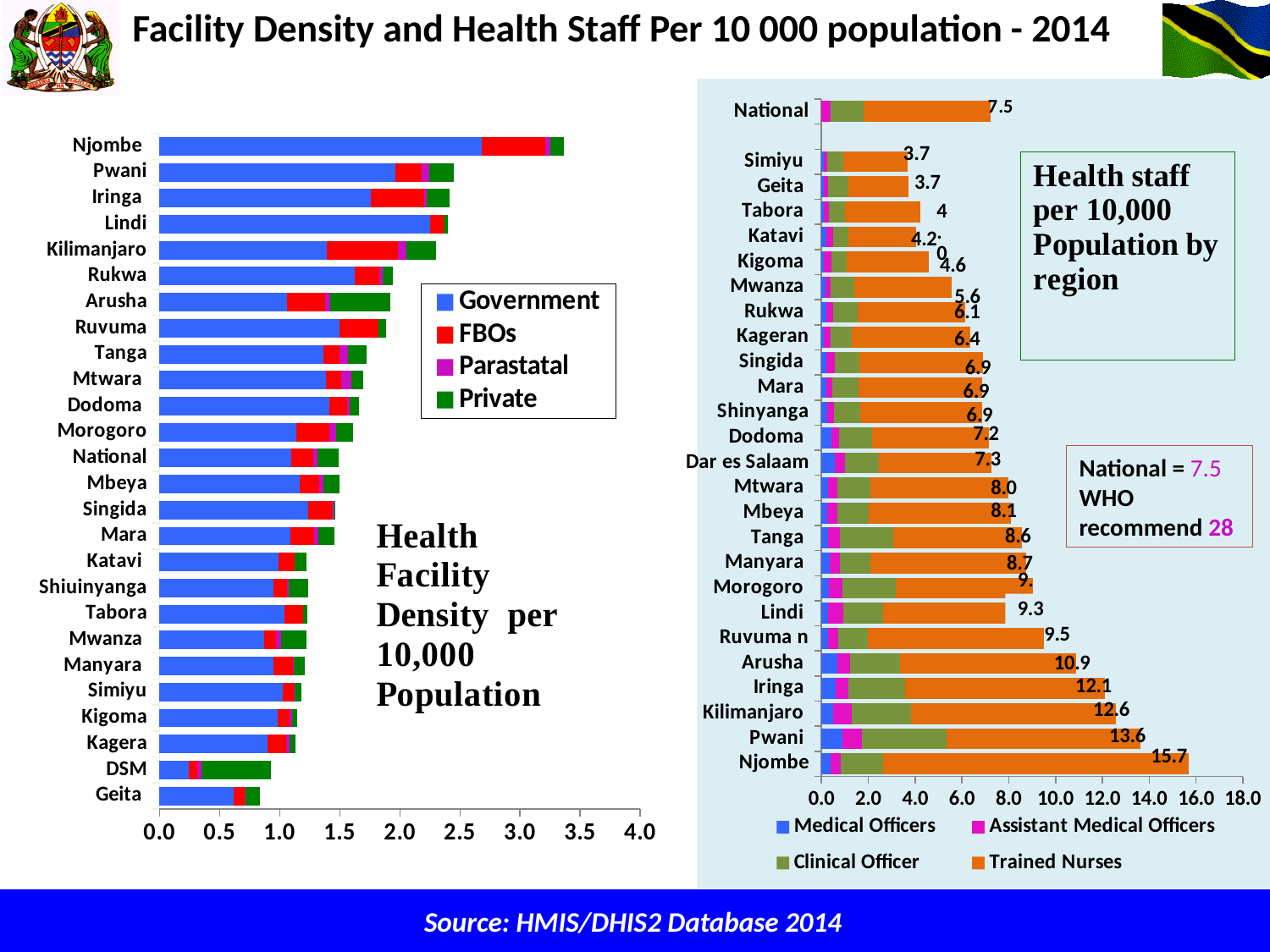
What kind of chart is the Health Facility Density per 10,000 Population chart on the left? Bar chart What are the four legend entries of the Health Facility Density per 10,000 Population chart? Government, FBOs, Parastatal, Private In the Health Facility Density per 10,000 Population chart, is the total value for Njombe greater or less than 3.0? greater In the Health staff per 10,000 Population by region chart, what is the value for Njombe? 15.7 In the Health staff per 10,000 Population by region chart, what is the difference between Njombe and Pwani? 2.1 In the Health staff per 10,000 Population by region chart, which region has the highest value? Njombe In the Health staff per 10,000 Population by region chart, what is the National value? 7.5 In the Health staff per 10,000 Population by region chart, which is larger, Arusha or Iringa? Iringa In the Health Facility Density per 10,000 Population chart, which category has the highest total? Njombe How many series does the legend of the Health staff per 10,000 Population by region chart list? 4 In the Health Facility Density per 10,000 Population chart, is the total value for Geita greater or less than 1.0? less In the Health staff per 10,000 Population by region chart, what is the value for Pwani? 13.6